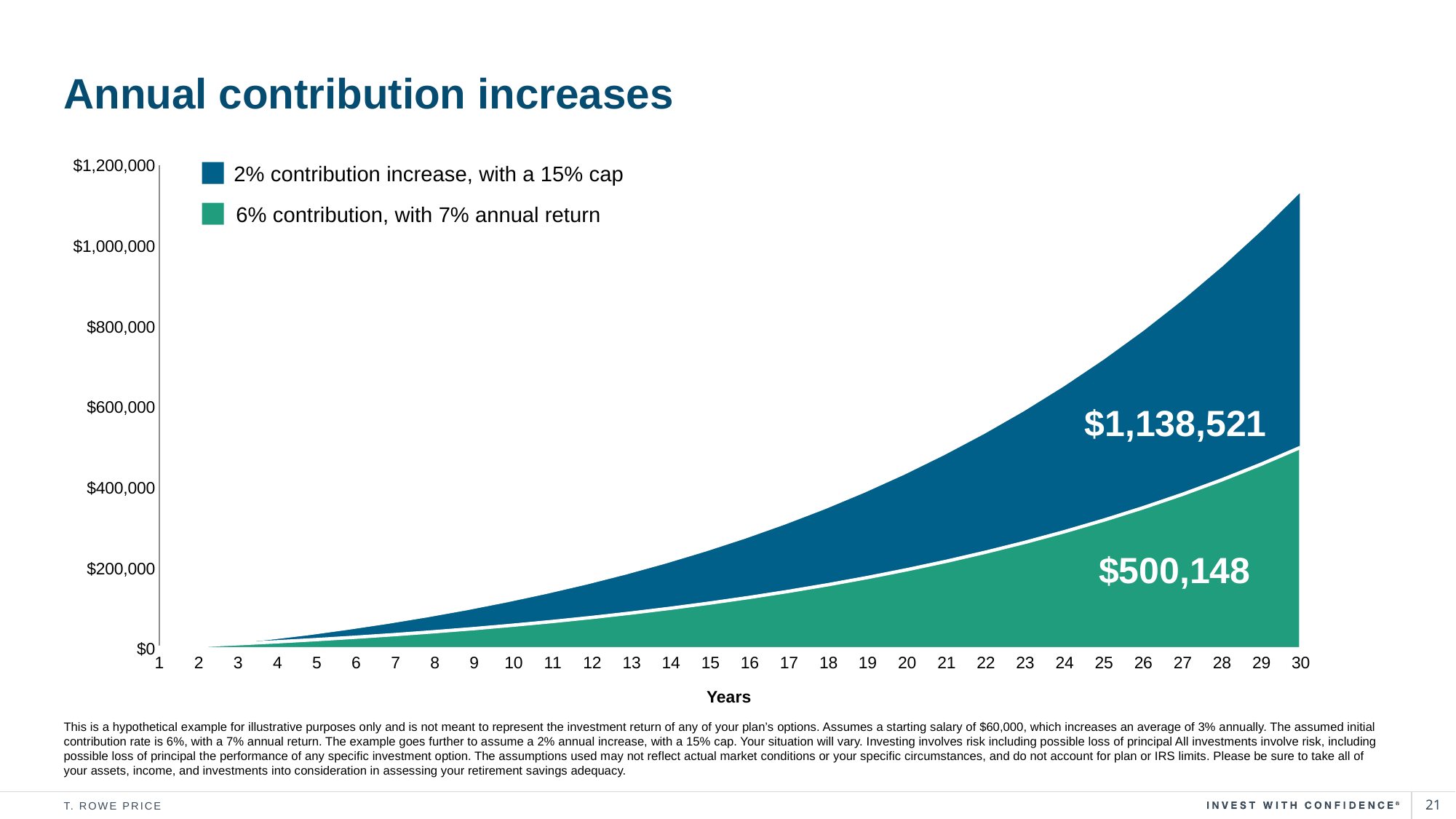
Do the values of the 2% contribution increase, with a 15% cap series rise or fall as the years increase? Rise Is the value for the 2% contribution increase, with a 15% cap series at year 25 greater or less than $400,000? greater What is the difference between the two labelled values at year 30, $1,138,521 and $500,148? $638,373 What is the value shown for the 6% contribution, with 7% annual return series at year 30? $500,148 What is the value shown for the 2% contribution increase, with a 15% cap series at year 30? $1,138,521 How many years are shown along the x axis of the chart? 30 How many series does the legend list? 2 What is the title of the chart on the slide? Annual contribution increases What kind of chart is shown on the slide? Area chart Which series has the larger value at year 30: the 2% contribution increase with a 15% cap, or the 6% contribution with 7% annual return? 2% contribution increase, with a 15% cap